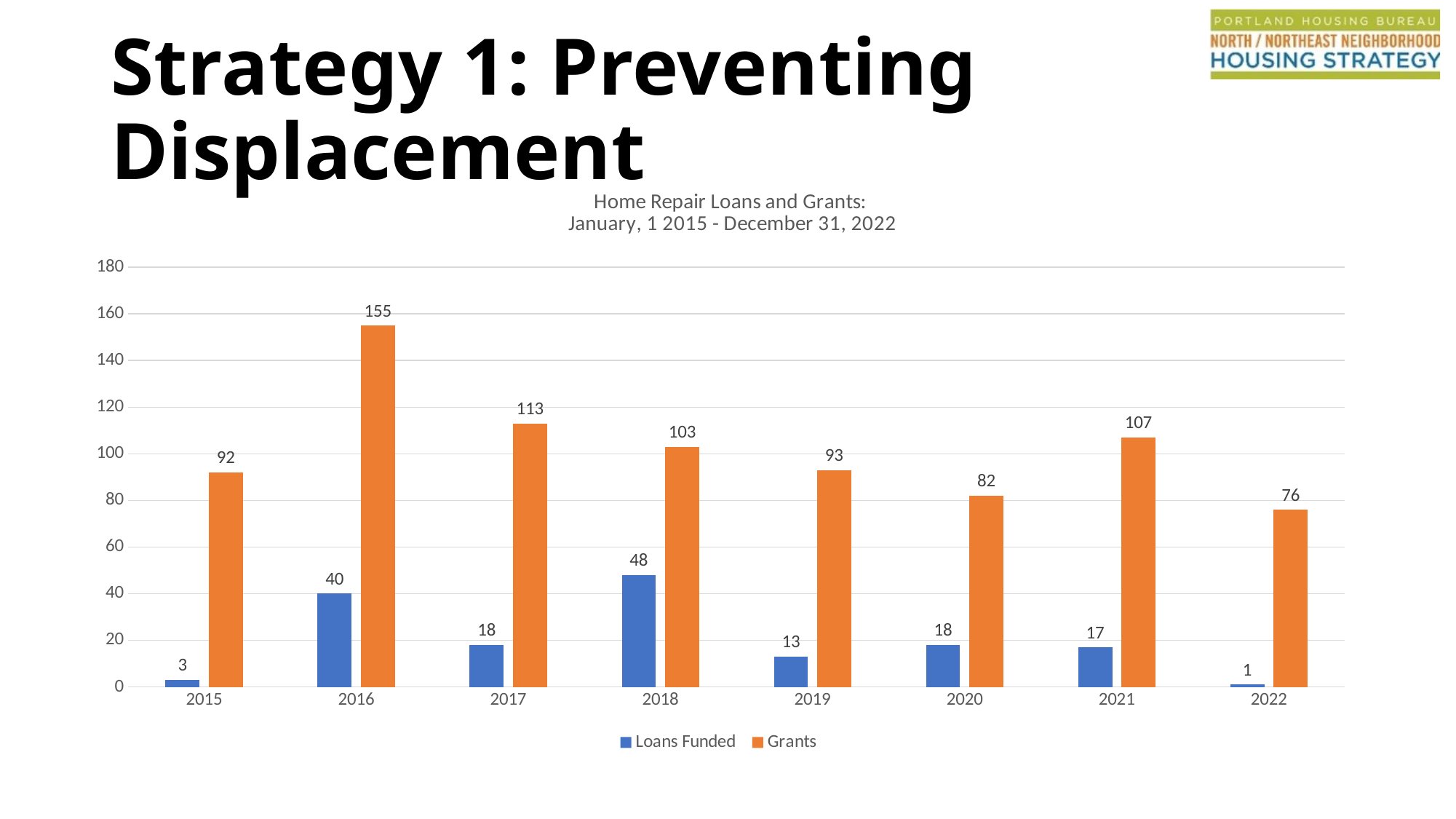
Which year has the lowest number of Loans Funded? 2022 Which is larger: Grants in 2017 or Grants in 2021? Grants in 2017 Which colour represents Loans Funded in the chart? Blue What is the title of the chart? Home Repair Loans and Grants: January, 1 2015 - December 31, 2022 How many series does the legend list? 2 Which year has the highest number of Grants? 2016 What is the difference between Grants in 2016 and Grants in 2022? 79 What kind of chart is shown on the slide? Bar chart How many years are shown on the x axis? 8 How many Grants were there in 2016? 155 What is the value for Loans Funded in 2018? 48 Do the Grants values rise or fall from 2019 to 2020? Fall